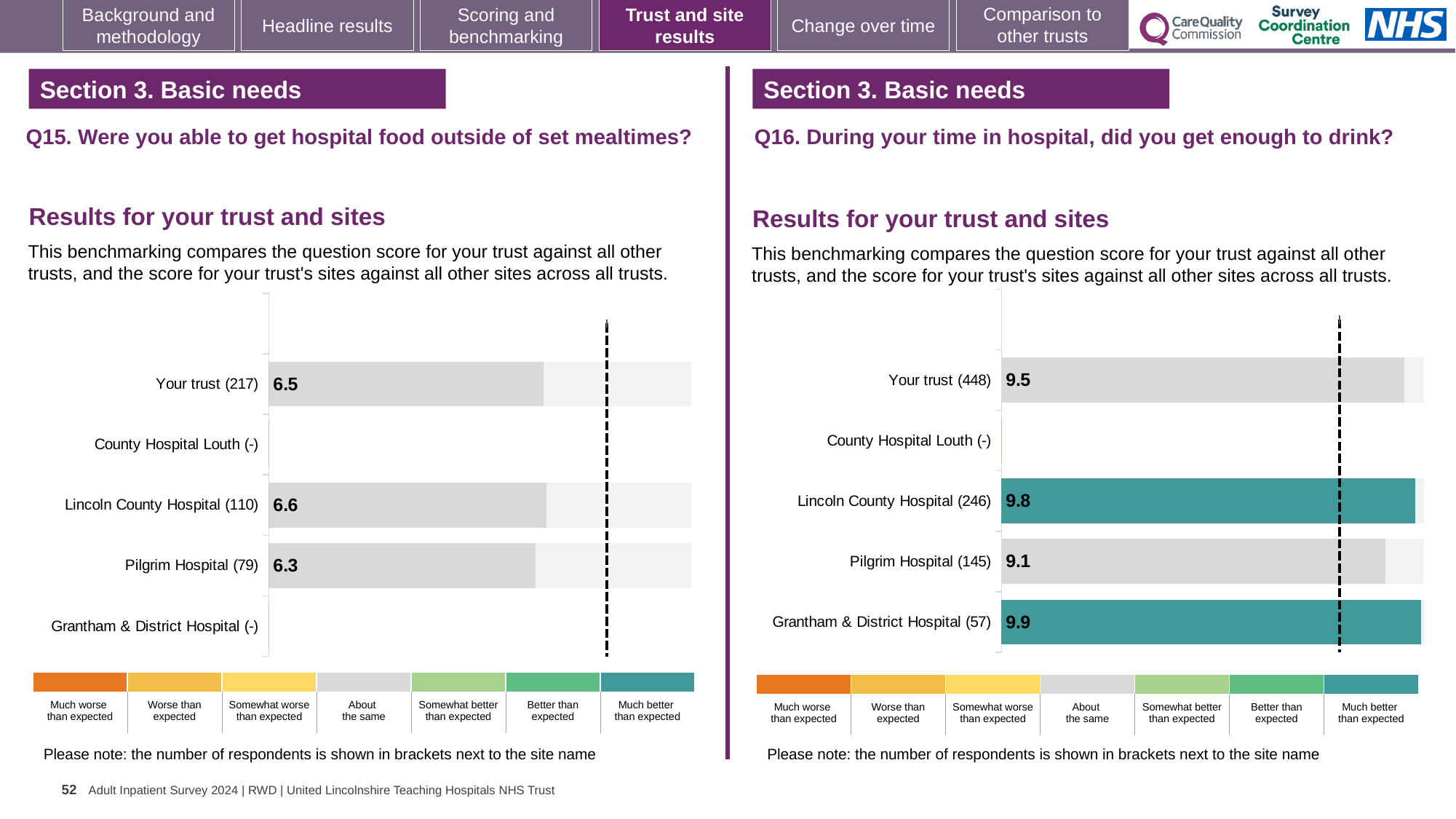
In the Q15 chart (left), what is the score for Pilgrim Hospital (79)? 6.3 In the Q15 chart (left), what is the score for Your trust (217)? 6.5 In the Q16 chart (right), which has the larger score: Your trust (448) or Lincoln County Hospital (246)? Lincoln County Hospital (246) In the Q16 chart (right), which row with a plotted score has the lowest score? Pilgrim Hospital (145) In the Q16 chart (right), which row has the highest score? Grantham & District Hospital (57) What kind of chart is used in the Q15 chart (left)? Bar chart In the Q15 chart (left), which site or trust row has the highest score? Lincoln County Hospital (110) In the Q15 chart (left), how many rows have a plotted bar with a score? 3 In the Q16 chart (right), what is the score for Lincoln County Hospital (246)? 9.8 In the Q16 chart (right), what is the difference between the scores for Grantham & District Hospital (57) and Pilgrim Hospital (145)? 0.8 In the Q16 chart (right), what is the score for Your trust (448)? 9.5 In the Q15 chart (left), what is the difference between the scores for Lincoln County Hospital (110) and Pilgrim Hospital (79)? 0.3